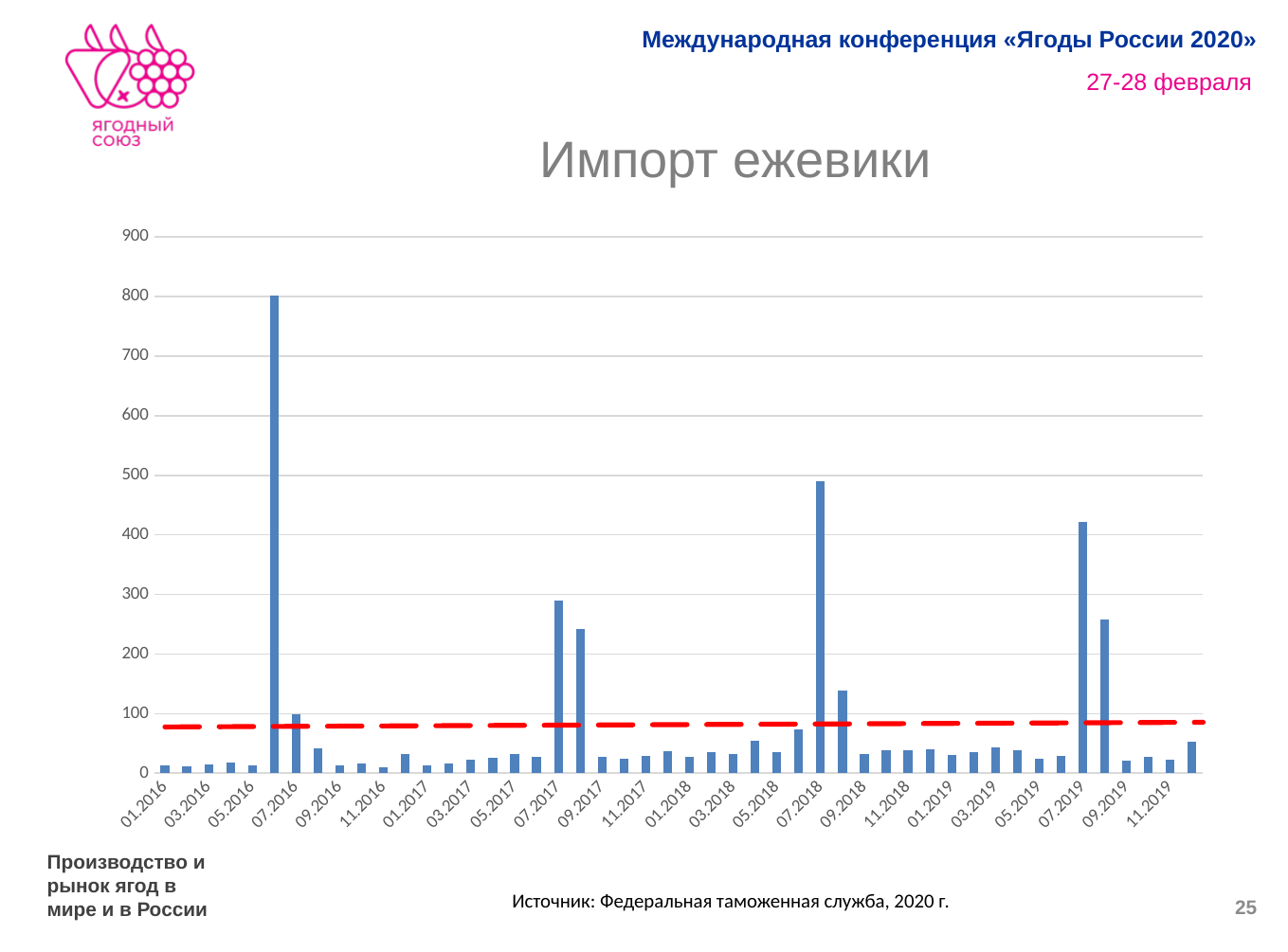
Is the value for 07.2016 greater or less than 700? less Is the value for 07.2019 greater or less than 300? greater Is the value for 07.2018 greater or less than 400? greater What is the title of the chart? Импорт ежевики Which is larger, the value for 07.2017 or the value for 09.2017? 07.2017 Which is larger, the value for 07.2016 or the value for 07.2018? 07.2018 What kind of chart is shown on the slide? bar chart Which is larger, the value for 07.2018 or the value for 07.2019? 07.2018 What is the highest value shown on the y axis? 900 Which month has the highest bar in the chart? 06.2016